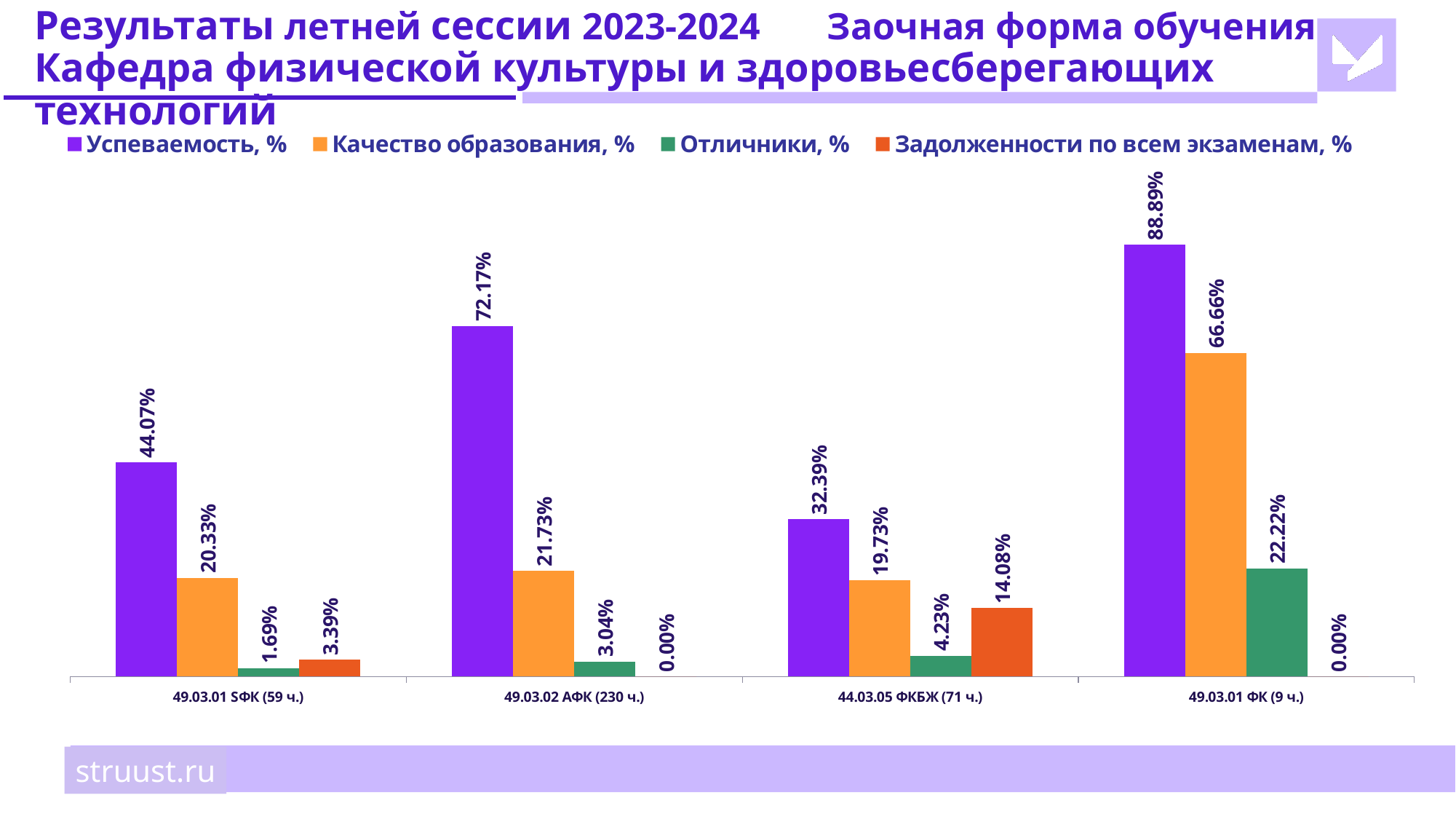
What is the difference between Успеваемость, % for 49.03.01 ФК (9 ч.) and for 49.03.01 SФК (59 ч.)? 44.82% Which colour represents the series Отличники, % in the legend? green Which category has the lowest value of Успеваемость, %? 44.03.05 ФКБЖ (71 ч.) How many series does the legend list? 4 What is the value of Качество образования, % for 49.03.01 ФК (9 ч.)? 66.66% Which is larger: Качество образования, % for 49.03.02 АФК (230 ч.) or for 44.03.05 ФКБЖ (71 ч.)? 49.03.02 АФК (230 ч.) How many categories are shown on the x axis? 4 What is the value of Отличники, % for 49.03.01 SФК (59 ч.)? 1.69% What is the value of Успеваемость, % for 49.03.02 АФК (230 ч.)? 72.17% Which category has the highest value of Успеваемость, %? 49.03.01 ФК (9 ч.) What type of chart is shown on the slide? bar chart What is the value of Задолженности по всем экзаменам, % for 44.03.05 ФКБЖ (71 ч.)? 14.08%